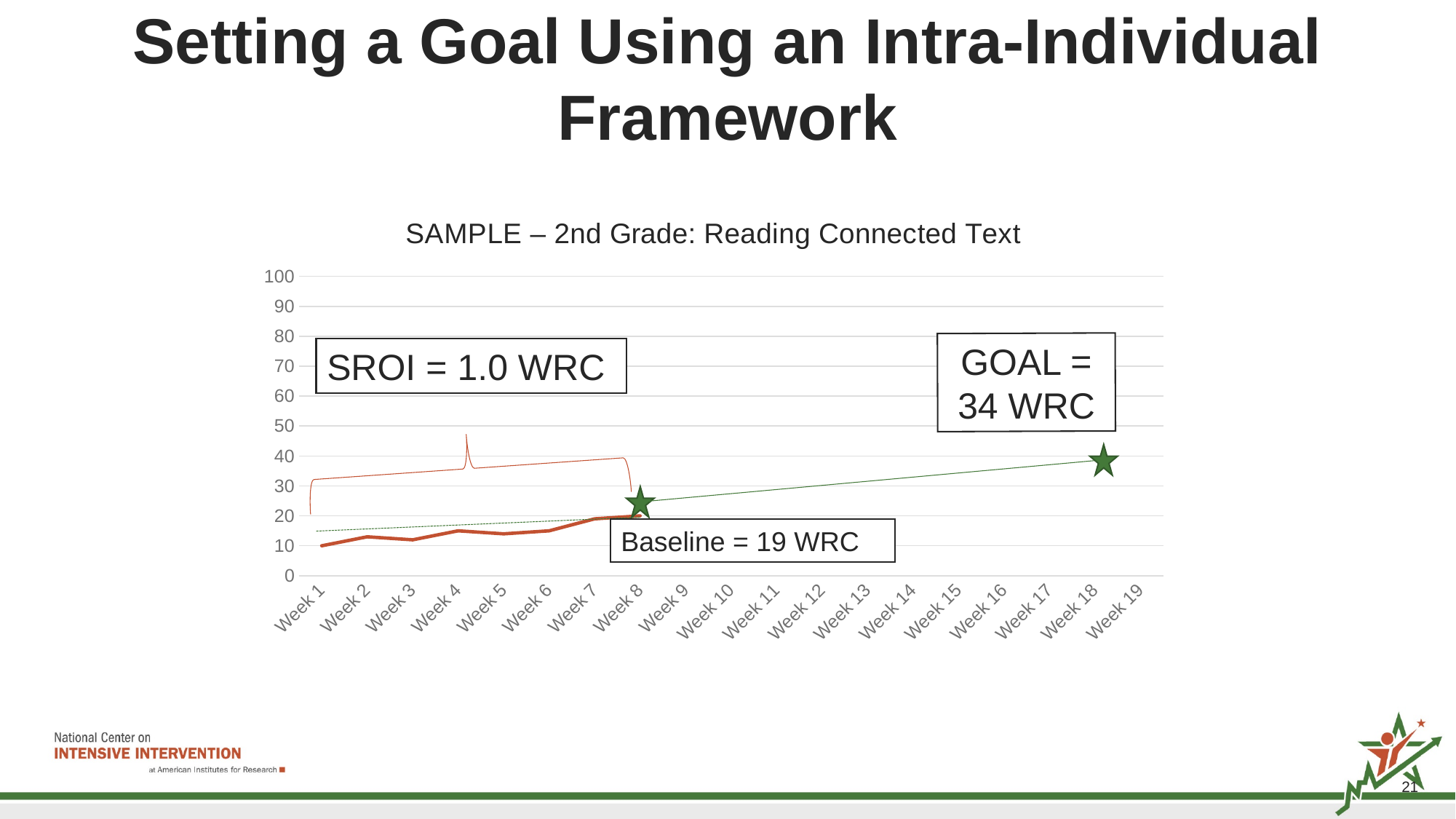
What kind of chart is shown on the slide? line chart Which is larger, the value for Week 1 or the value for Week 7? Week 7 What baseline value is stated on the chart? 19 WRC What is the title of the chart? SAMPLE – 2nd Grade: Reading Connected Text What goal value is stated on the chart? 34 WRC Is the value at the goal star at Week 18 greater or less than 30? greater What SROI value is stated on the chart? 1.0 WRC Is the value for Week 1 greater or less than 20? less How many weeks are shown on the x axis of the chart? 19 Does the red data line rise or fall from Week 1 to Week 8? rise Which week has the lowest value on the red data line? Week 1 What is the highest value shown on the y axis? 100